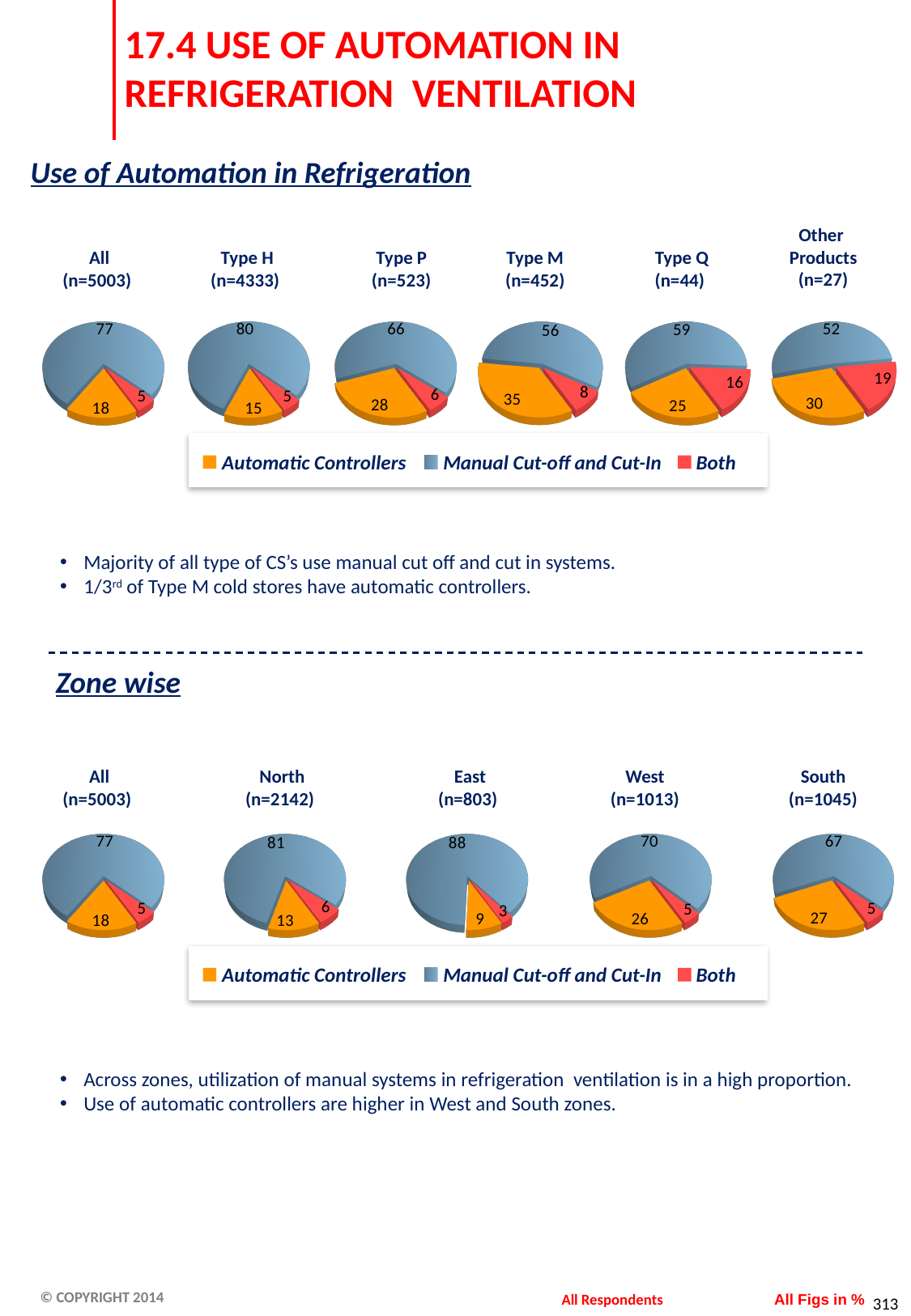
In the 'Use of Automation in Refrigeration' pie charts, what is the value for Both in the Other Products (n=27) pie? 19 In the 'Use of Automation in Refrigeration' pie charts, what is the value for Manual Cut-off and Cut-In in the Type H (n=4333) pie? 80 Across the 'Use of Automation in Refrigeration' pie charts, which type has the highest value for Automatic Controllers? Type M (n=452) How many pie charts are shown in the 'Zone wise' section? 5 In the 'Zone wise' pie charts, what is the value for Automatic Controllers in the South (n=1045) pie? 27 How many series does the legend of the 'Use of Automation in Refrigeration' charts list? 3 In the 'Zone wise' pie charts, which is larger: the Automatic Controllers value for West or for North? West What type of chart is used in the 'Zone wise' section? Pie chart Across the 'Zone wise' pie charts, which zone has the lowest value for Automatic Controllers? East (n=803) In the 'Use of Automation in Refrigeration' pie charts, what is the value for Automatic Controllers in the Type M (n=452) pie? 35 In the 'Zone wise' pie charts, what is the value for Manual Cut-off and Cut-In in the East (n=803) pie? 88 In the 'Use of Automation in Refrigeration' pie charts, what is the difference between the Manual Cut-off and Cut-In values for Type H and Type P? 14